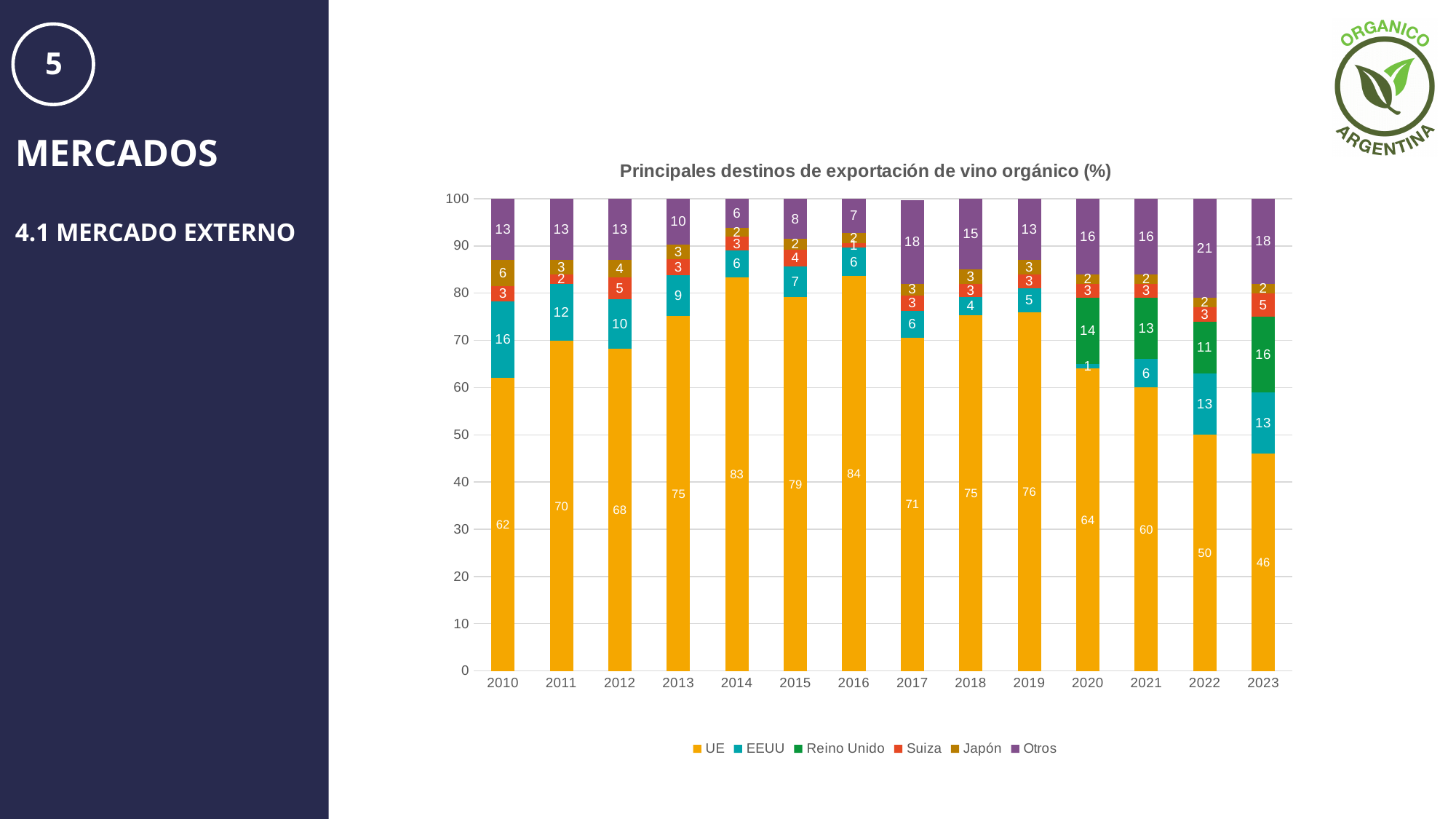
In which year is the UE value lowest? 2023 Which is larger, the EEUU value in 2010 or in 2011? 2010 What is the difference between the UE value in 2010 and in 2023? 16 What is the value for Reino Unido in 2023? 16 In which year is the UE value highest? 2016 How many years are shown on the x axis? 14 What is the value for Otros in 2017? 18 What is the value for UE in 2023? 46 Does the UE value rise or fall from 2019 to 2023? Fall What kind of chart is shown on the slide? Stacked bar chart In which year is the Otros value highest? 2022 How many series does the legend list? 6